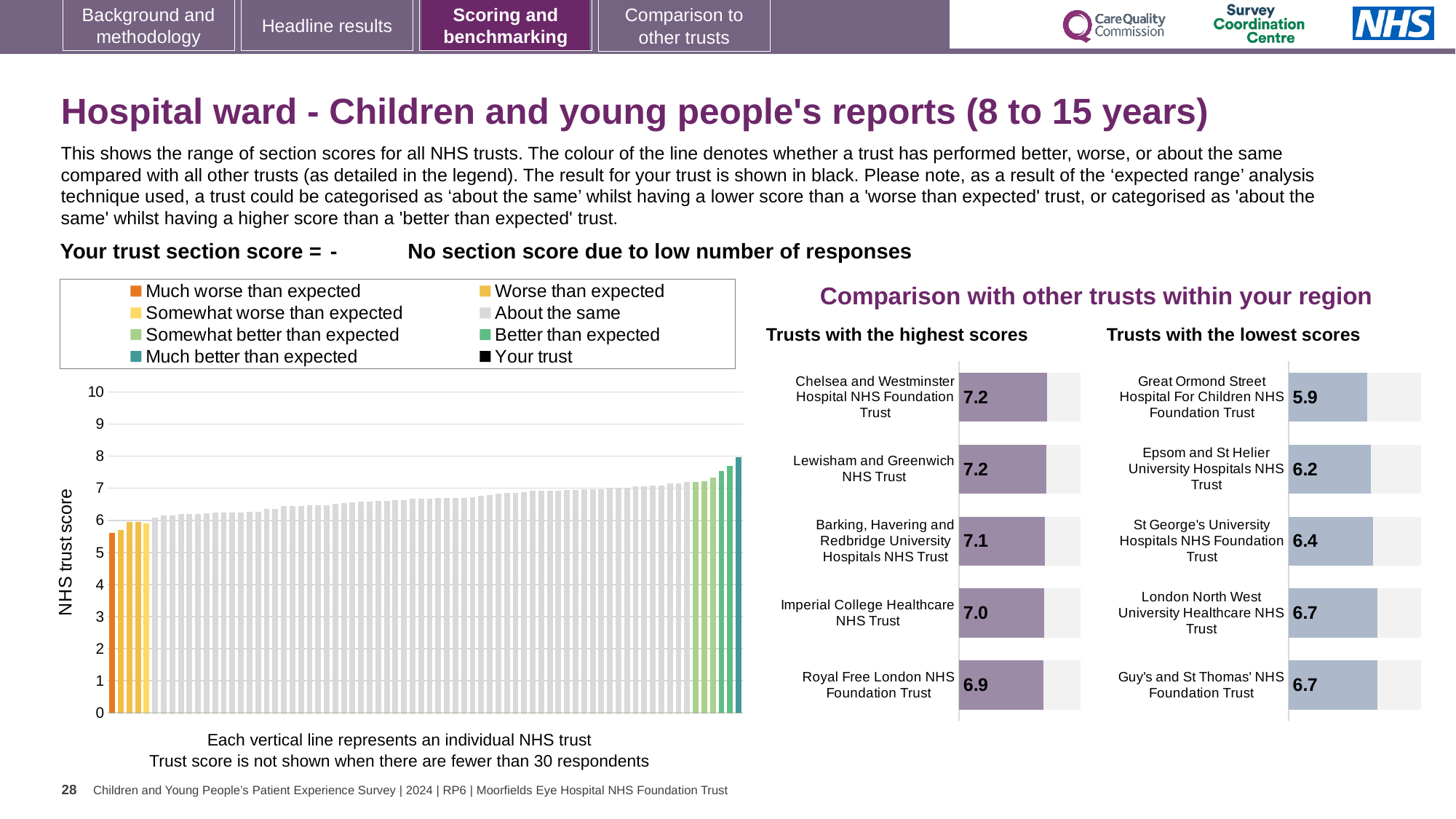
In the 'Trusts with the lowest scores' chart, which trust has the lowest score? Great Ormond Street Hospital For Children NHS Foundation Trust In the 'Trusts with the lowest scores' chart, which is larger: the score for Epsom and St Helier University Hospitals NHS Trust or the score for London North West University Healthcare NHS Trust? London North West University Healthcare NHS Trust In the 'Trusts with the lowest scores' chart, what is the difference between the score for Epsom and St Helier University Hospitals NHS Trust and the score for Great Ormond Street Hospital For Children NHS Foundation Trust? 0.3 In the 'Trusts with the highest scores' chart, what is the score for Royal Free London NHS Foundation Trust? 6.9 In the 'Trusts with the highest scores' chart, what is the difference between the score for Chelsea and Westminster Hospital NHS Foundation Trust and the score for Royal Free London NHS Foundation Trust? 0.3 How many entries does the legend above the NHS trust score chart list? 8 In the NHS trust score chart on the left, do the bar values rise or fall from left to right? rise How many trusts are shown in the 'Trusts with the highest scores' chart? 5 In the 'Trusts with the lowest scores' chart, what is the score for Great Ormond Street Hospital For Children NHS Foundation Trust? 5.9 In the NHS trust score chart on the left, is the value of the orange 'Much worse than expected' bar greater or less than 6? less In the 'Trusts with the lowest scores' chart, what is the score for St George's University Hospitals NHS Foundation Trust? 6.4 In the 'Trusts with the highest scores' chart, what is the score for Imperial College Healthcare NHS Trust? 7.0